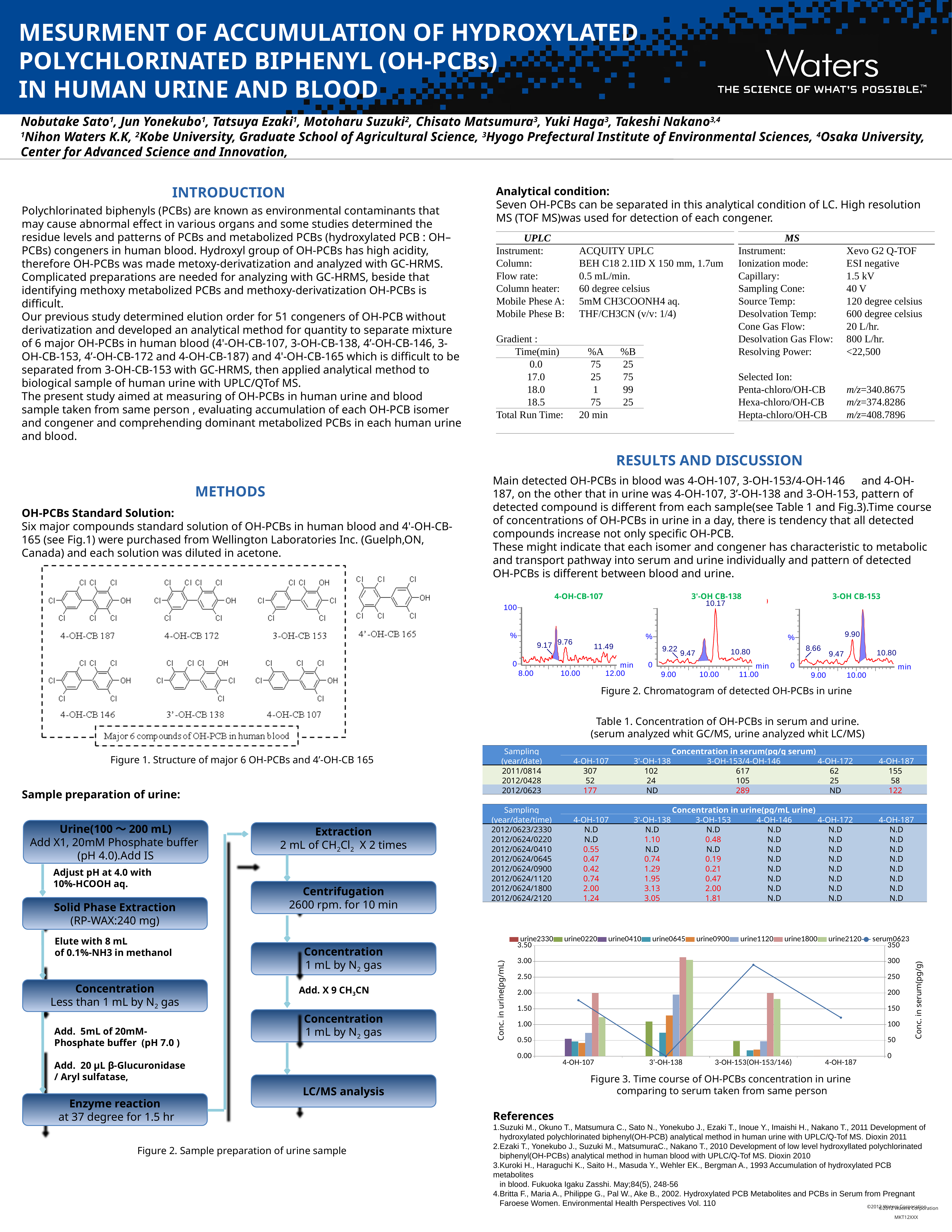
In Figure 3, which category has the lowest serum0623 value? 3'-OH-138 In Figure 3, what kind of chart is used to show the urine concentrations? bar chart In Figure 3, how many series does the legend list? 9 In Figure 3, is the urine1800 bar for 3'-OH-138 greater or less than 2.50? greater In the 3'-OH CB-138 chromatogram of Figure 2, what retention time is labelled on the tallest peak? 10.17 In Figure 3, which category has the highest serum0623 value? 3-OH-153(OH-153/146) In Figure 3, is the serum0623 value for 4-OH-107 greater or less than 200 on the right axis? less In Figure 3, which is larger for 3'-OH-138: the urine1120 bar or the urine0900 bar? urine1120 In Figure 3, what is the title of the left vertical axis? Conc. in urine(pg/mL) In Figure 3, how many OH-PCB categories are shown on the x axis? 4 In Figure 3, which is larger for 4-OH-107: the urine1800 bar or the urine2120 bar? urine1800 In Figure 3, is the serum0623 value for 3-OH-153(OH-153/146) greater or less than 250 on the right axis? greater